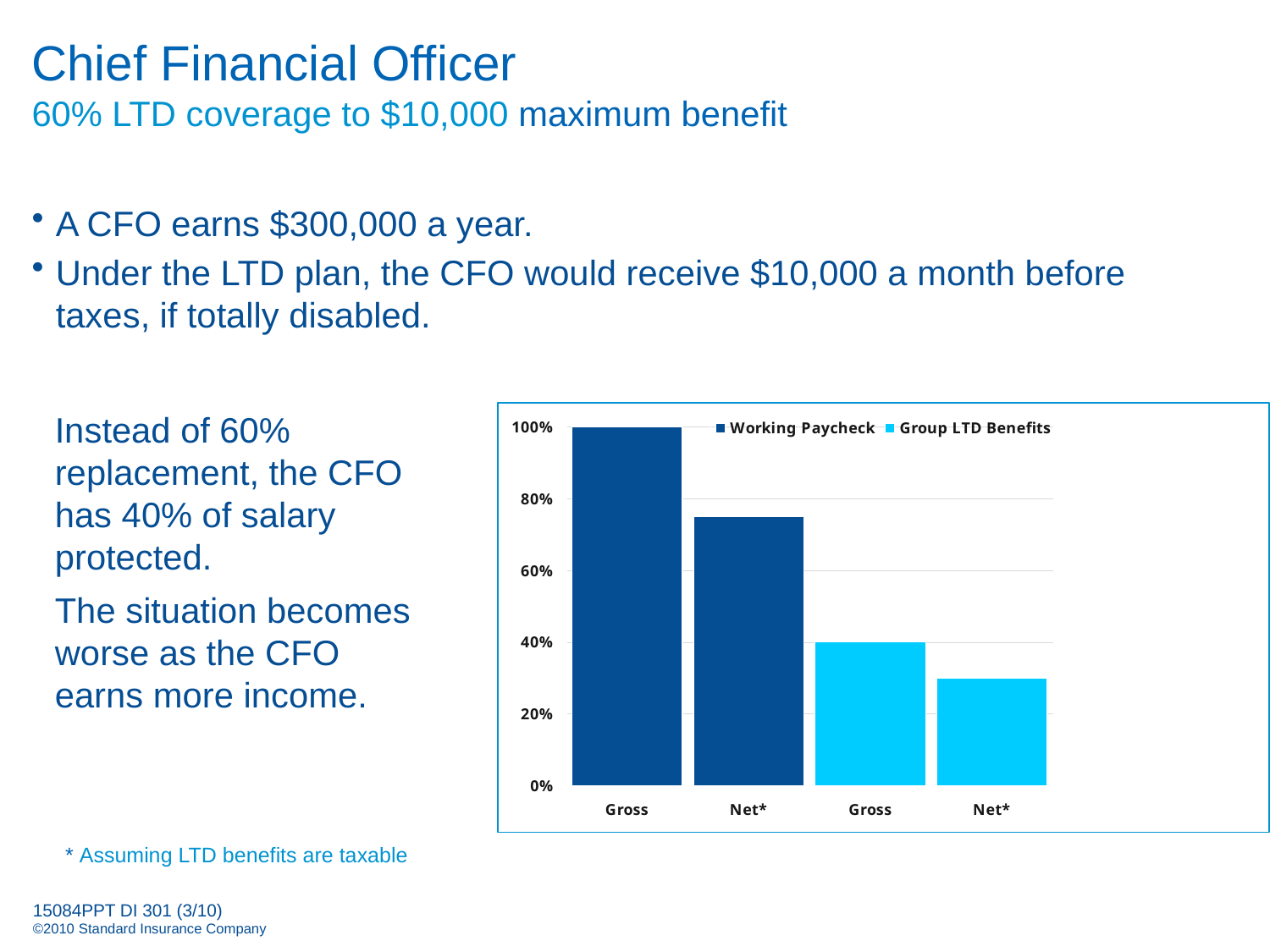
How many bars are plotted in the chart? 4 Is the value of the Net* bar for Working Paycheck greater or less than 60%? greater How many series does the chart legend list? 2 What is the value of the Gross bar for Group LTD Benefits? 40% Which bar in the chart is the lowest? Group LTD Benefits Net* What is the value of the Gross bar for Working Paycheck? 100% Which bar in the chart is the highest? Working Paycheck Gross What is the difference between the Gross bar for Working Paycheck and the Gross bar for Group LTD Benefits? 60% Which is larger: the Net* bar for Working Paycheck or the Gross bar for Group LTD Benefits? Net* bar for Working Paycheck What kind of chart is shown on the slide? bar chart What are the two series named in the chart legend? Working Paycheck and Group LTD Benefits Is the value of the Net* bar for Group LTD Benefits greater or less than 40%? less